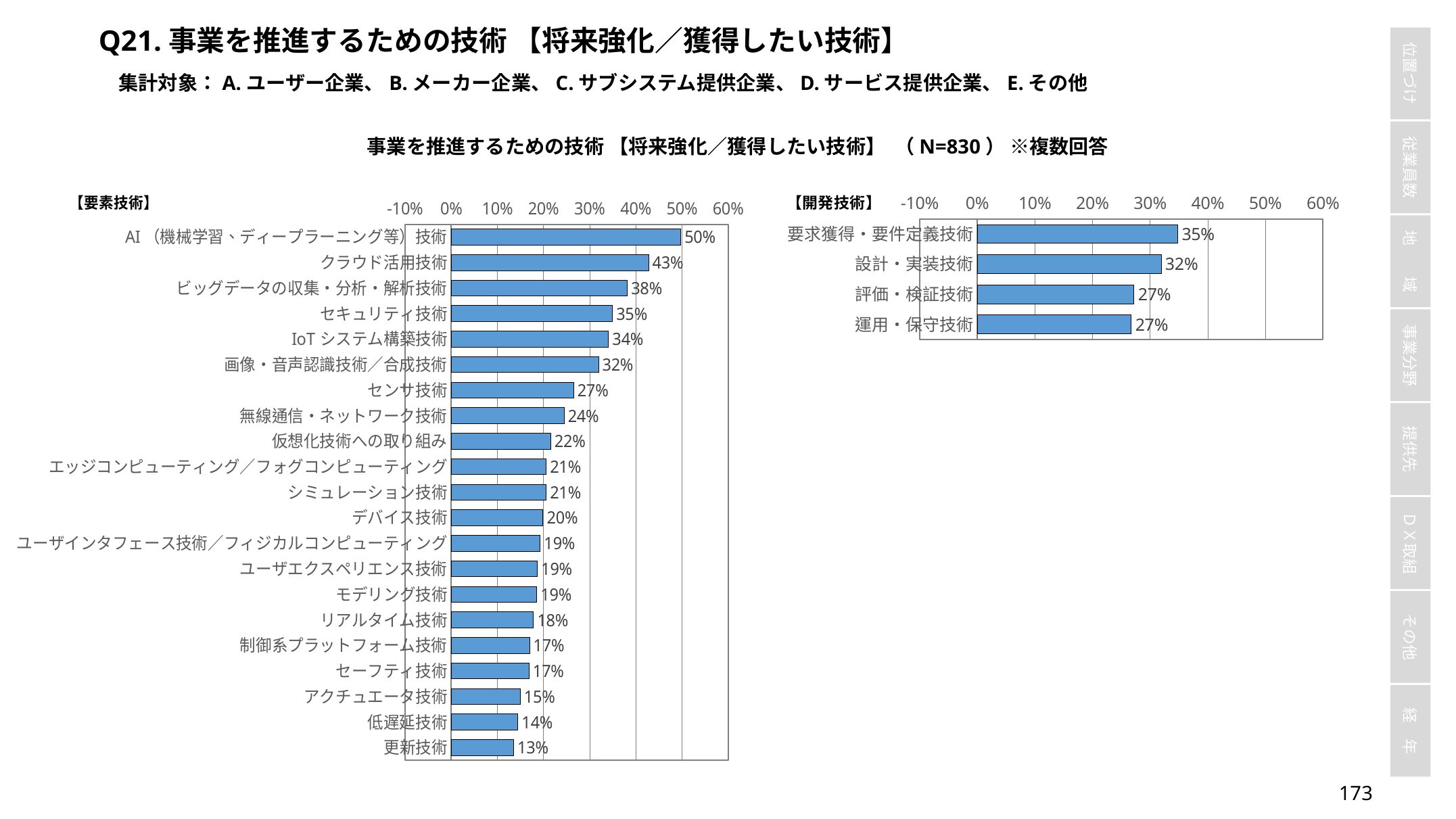
In the 【要素技術】 chart, what is the value for クラウド活用技術? 43% In the 【要素技術】 chart, which category has the highest value? AI（機械学習、ディープラーニング等）技術 In the 【要素技術】 chart, which is larger: the value for IoTシステム構築技術 or the value for 無線通信・ネットワーク技術? IoTシステム構築技術 In the 【開発技術】 chart, which category has the highest value? 要求獲得・要件定義技術 In the 【開発技術】 chart, what is the difference between the values for 要求獲得・要件定義技術 and 評価・検証技術? 8% In the 【要素技術】 chart, which category has the lowest value? 更新技術 How many categories are shown in the 【要素技術】 chart? 21 In the 【要素技術】 chart, what is the value for センサ技術? 27% What kind of chart is the 【開発技術】 chart? Bar chart How many categories are shown in the 【開発技術】 chart? 4 In the 【要素技術】 chart, what is the difference between the values for AI（機械学習、ディープラーニング等）技術 and セキュリティ技術? 15% In the 【開発技術】 chart, what is the value for 設計・実装技術? 32%